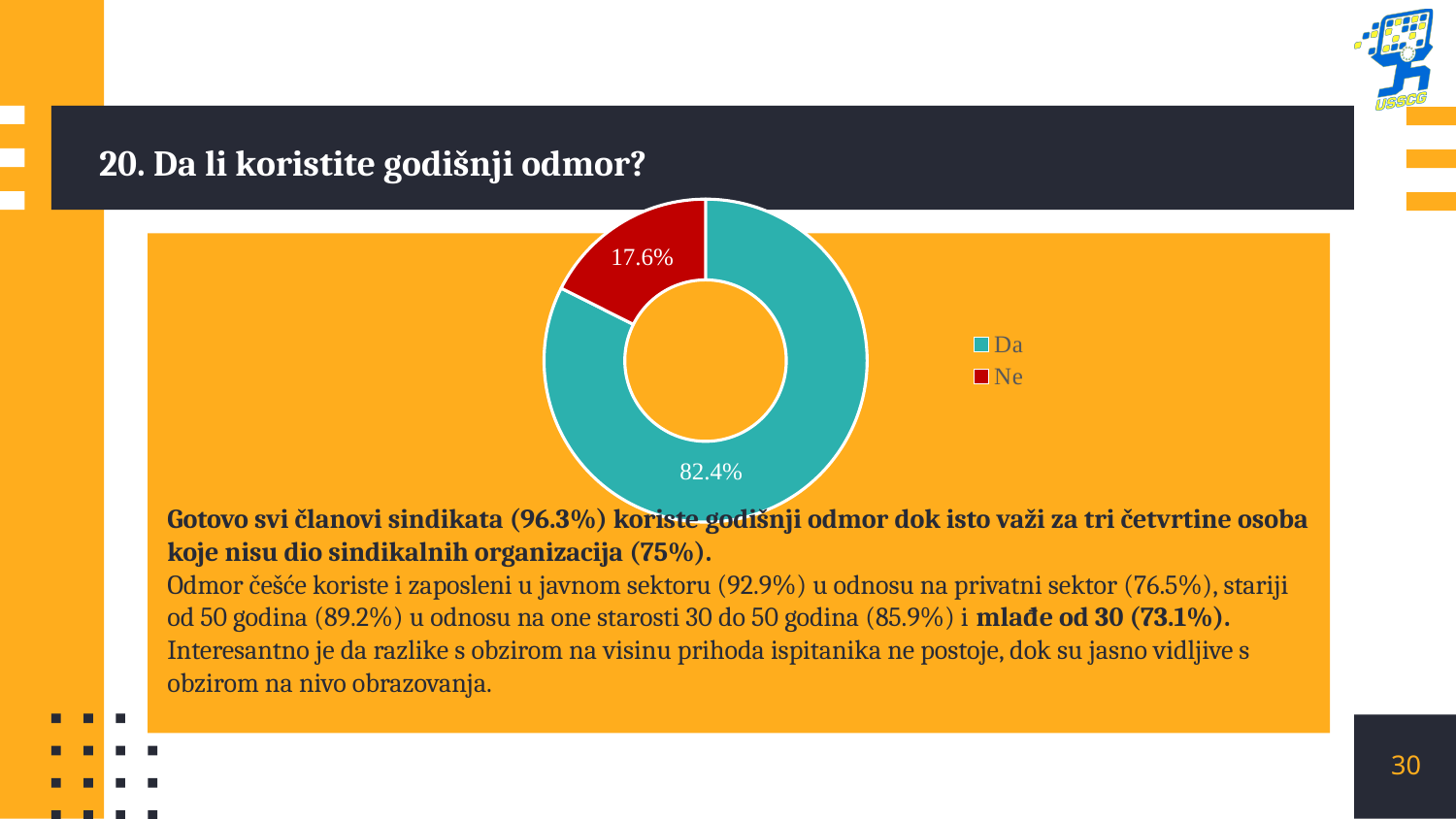
What is the difference in percentage points between the "Da" and "Ne" shares? 64.8 Which is larger, the share for "Da" or the share for "Ne"? Da What percentage of respondents answered "Ne"? 17.6% How many categories does the chart show? 2 What colour is the "Ne" slice in the chart? Red Which category has the smallest share of the chart? Ne Which category has the largest share of the chart? Da What kind of chart is shown on the slide? Doughnut (pie) chart What colour is the "Da" slice in the chart? Teal What percentage of respondents answered "Da"? 82.4% What is the share of the chart taken by the "Ne" slice? 17.6%